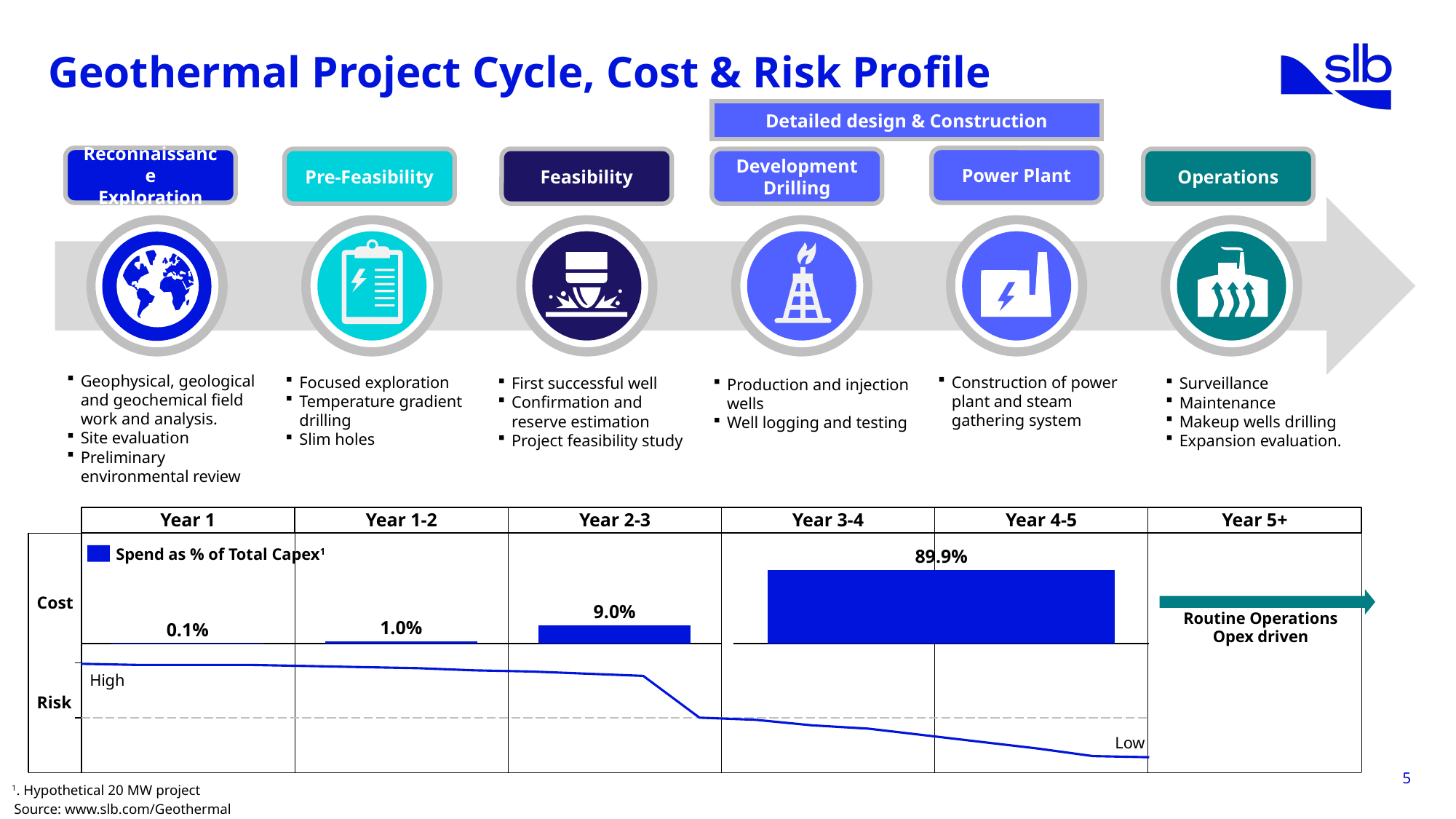
In the Cost chart, what is the spend as % of total capex for Year 1? 0.1% How many bars with data labels are shown in the Cost chart? 4 In the Cost chart, which is larger: the spend for Year 1-2 or Year 2-3? Year 2-3 In the Cost chart, which period has the lowest spend as % of total capex? Year 1 In the Cost chart, what is the spend as % of total capex shown for the Year 3-4 to Year 4-5 period? 89.9% What kind of chart is used to show spend as % of total capex in the Cost row? Bar chart In the Cost chart, what is the spend as % of total capex for Year 1-2? 1.0% In the Cost chart, what is the spend as % of total capex for Year 2-3? 9.0% In the Cost chart, which period has the highest spend as % of total capex? Year 3-4 to Year 4-5 In the Risk chart, does the risk line rise or fall from Year 1 to Year 4-5? Fall What is the legend label for the bars in the Cost chart? Spend as % of Total Capex In the Cost chart, what is the difference between the spend for Year 2-3 and Year 1-2? 8.0%